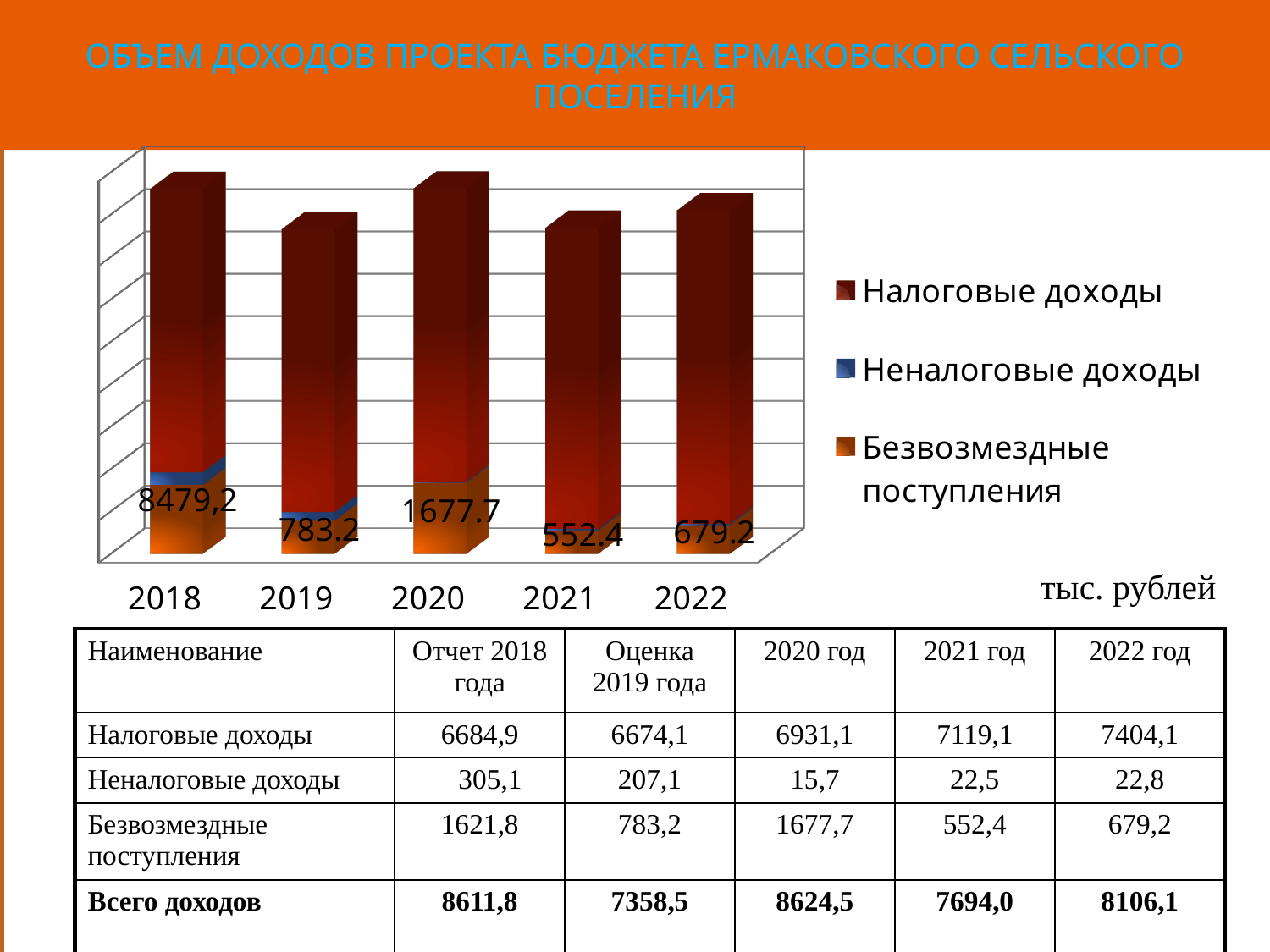
What is the difference between the chart's labeled values for Безвозмездные поступления in 2020 and 2021? 1125.3 What is the data label shown on the chart for Безвозмездные поступления in 2022? 679.2 Which year has the larger labeled value for Безвозмездные поступления on the chart, 2019 or 2022? 2019 How many years are shown on the x axis of the chart? 5 Among the years 2019 to 2022, which year has the highest labeled value for Безвозмездные поступления on the chart? 2020 What is the data label shown on the chart for Безвозмездные поступления in 2021? 552.4 Among the years 2019 to 2022, which year has the lowest labeled value for Безвозмездные поступления on the chart? 2021 What is the data label shown on the chart for Безвозмездные поступления in 2020? 1677.7 What is the data label shown on the chart for Безвозмездные поступления in 2019? 783.2 What kind of chart is shown on the slide? Stacked bar chart How many series does the chart legend list? 3 Which series is listed first in the chart legend? Налоговые доходы